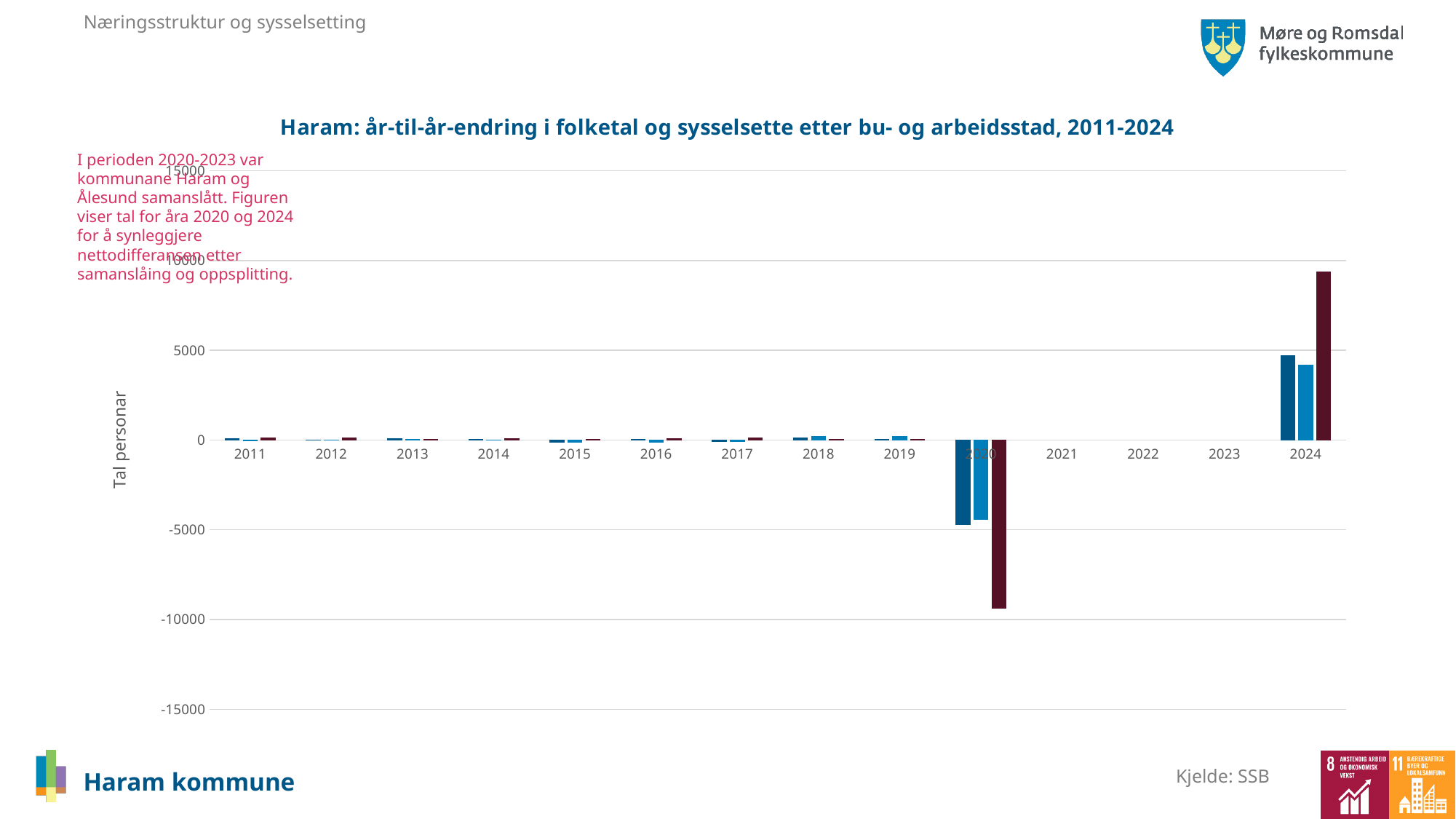
Is the value of the dark blue bar for 2020 greater or less than 0? less Is the value of the dark red bar for 2020 greater or less than -5000? less Which year has the larger dark red bar, 2024 or 2019? 2024 What is the label on the vertical axis of the chart? Tal personar How many years are labelled along the x axis of the chart? 14 Is the value of the light blue bar for 2024 greater or less than 0? greater What is the title of the chart? Haram: år-til-år-endring i folketal og sysselsette etter bu- og arbeidsstad, 2011-2024 Which year has the lowest (most negative) bar in the chart? 2020 Which year has the tallest positive bar in the chart? 2024 Which years between 2011 and 2024 have no bars plotted in the chart? 2021, 2022, 2023 What kind of chart is shown on the slide? bar chart